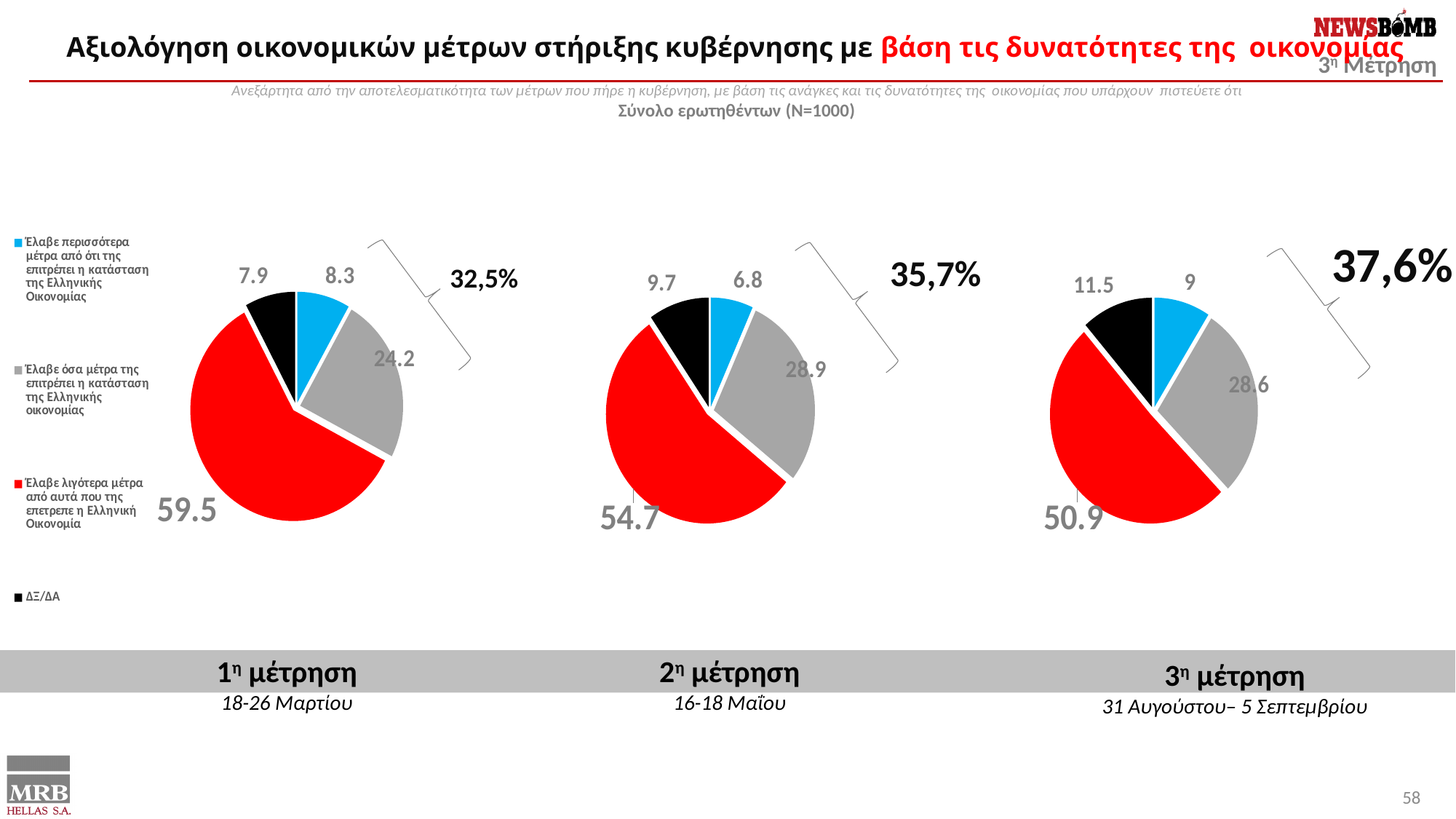
In the pie chart for the 3η μέτρηση (31 Αυγούστου – 5 Σεπτεμβρίου), what is the value of the blue slice (Έλαβε περισσότερα μέτρα από ότι της επιτρέπει η κατάσταση της Ελληνικής Οικονομίας)? 9 Is the grey slice larger in the 1η μέτρηση pie chart or in the 2η μέτρηση pie chart? 2η μέτρηση What is the difference between the red slice value in the 1η μέτρηση pie chart (59.5) and the red slice value in the 3η μέτρηση pie chart (50.9)? 8.6 What type of charts are shown on the slide? Pie charts In the pie chart for the 2η μέτρηση, which category has the smallest slice? Έλαβε περισσότερα μέτρα από ότι της επιτρέπει η κατάσταση της Ελληνικής Οικονομίας How does the red slice value (Έλαβε λιγότερα μέτρα) change from the 1η μέτρηση to the 3η μέτρηση? It falls In the pie chart for the 3η μέτρηση, what is the value of the black ΔΞ/ΔΑ slice? 11.5 In the pie chart for the 2η μέτρηση (16-18 Μαΐου), what is the value of the grey slice (Έλαβε όσα μέτρα της επιτρέπει η κατάσταση της Ελληνικής οικονομίας)? 28.9 What bracketed percentage is shown next to the pie chart for the 3η μέτρηση? 37,6% How many slices does each pie chart on the slide have? 4 In the pie chart for the 1η μέτρηση (18-26 Μαρτίου), what is the value of the red slice (Έλαβε λιγότερα μέτρα από αυτά που της επέτρεπε η Ελληνική Οικονομία)? 59.5 In the pie chart for the 1η μέτρηση, which category has the largest slice? Έλαβε λιγότερα μέτρα από αυτά που της επέτρεπε η Ελληνική Οικονομία